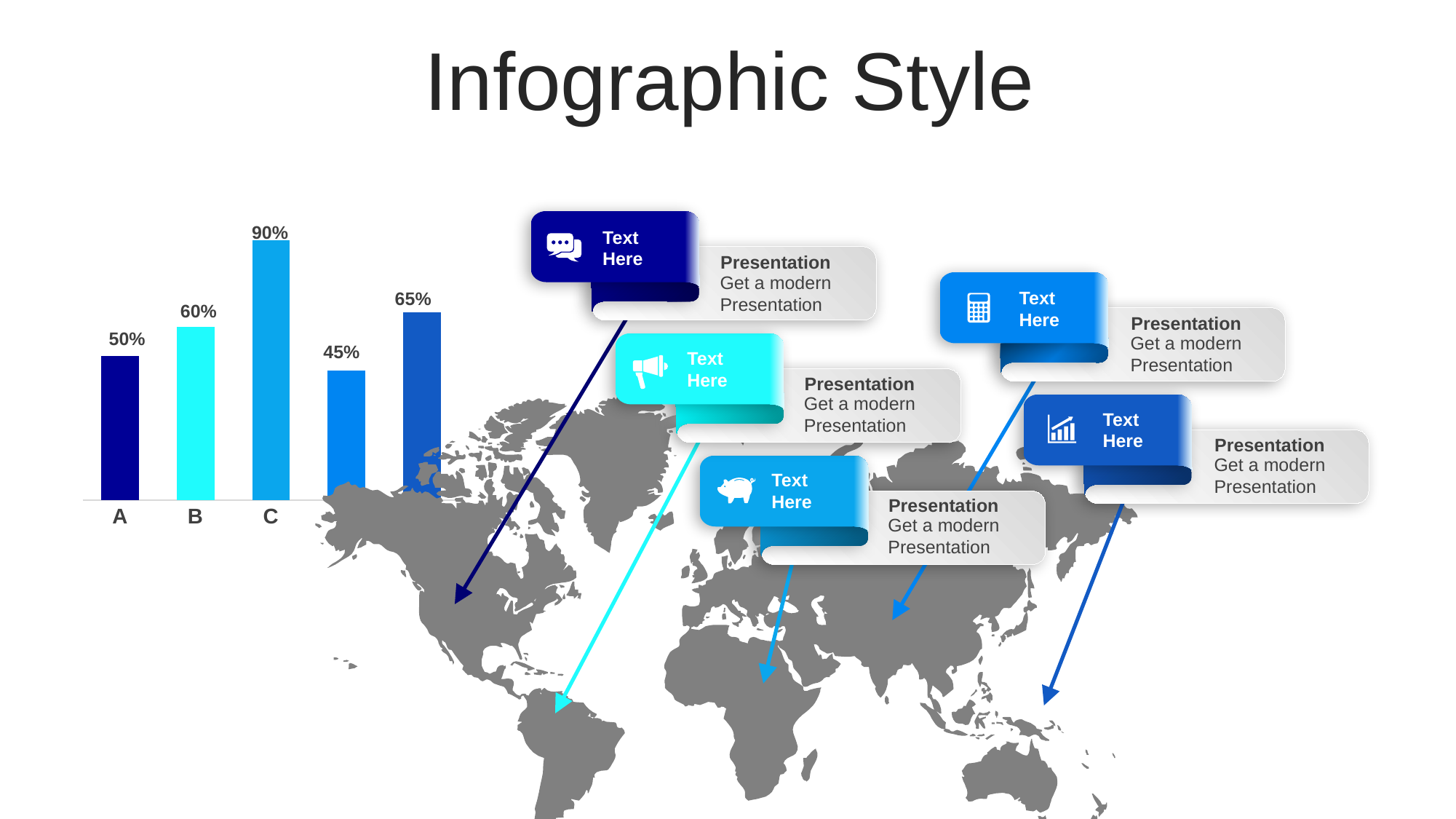
What is the value for category A in the bar chart? 50% What is the lowest value labelled on any bar in the chart? 45% How many bars are plotted in the bar chart? 5 What kind of chart is shown on the left of the slide? Bar chart What is the difference between the values for B and A? 10% What is the value for category B in the bar chart? 60% What is the value for category C in the bar chart? 90% Which is larger, the value for C or the value for B? C What is the difference between the values for C and A? 40% Which is larger, the value for B or the value for A? B Do the values rise or fall from category A to category C? Rise Which category has the highest value in the bar chart? C